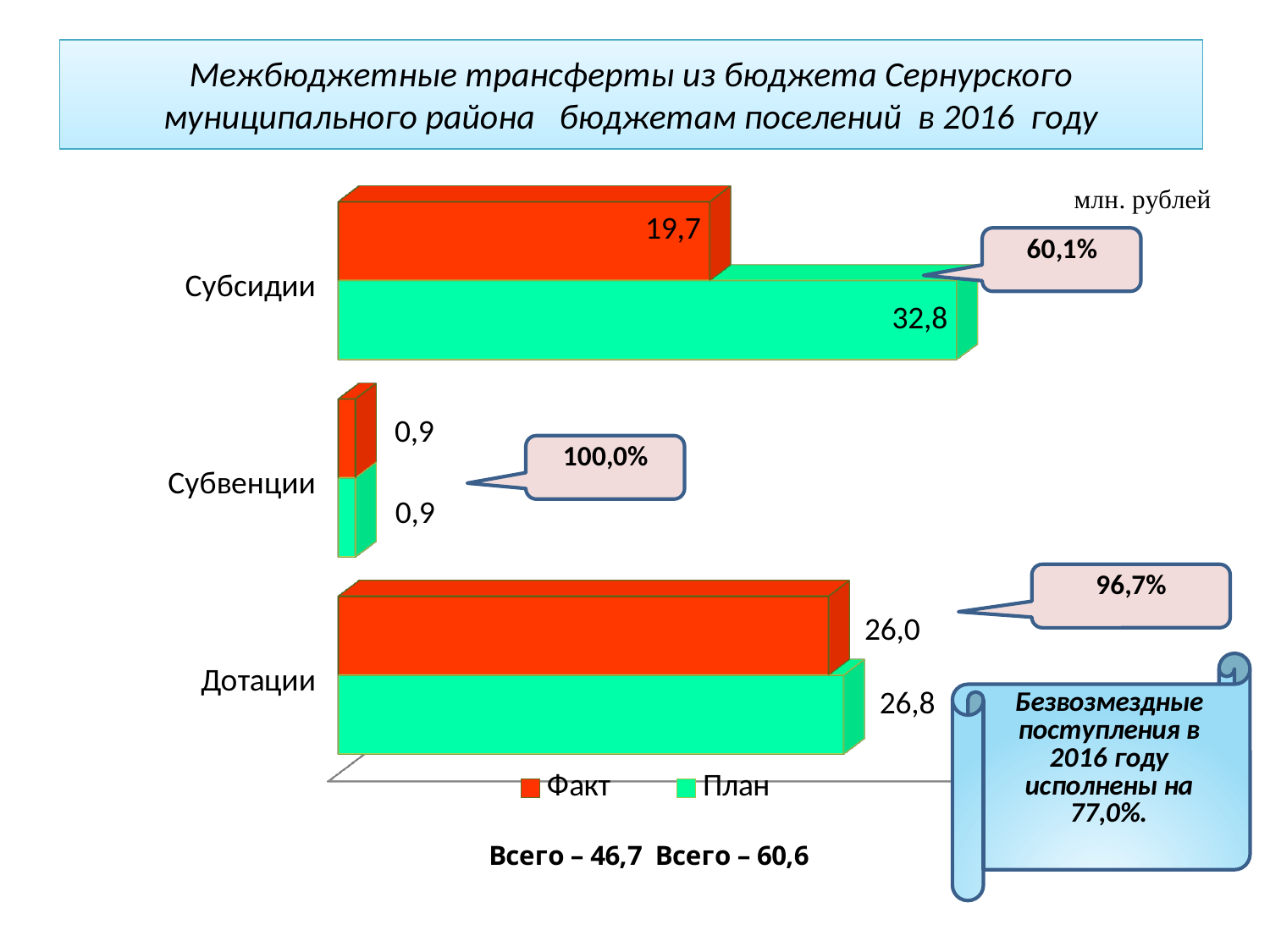
What is the difference between the План and Факт values for Субсидии? 13,1 What kind of chart is shown on the slide? Bar chart How many categories are shown on the chart? 3 What is the Факт value for Субсидии? 19,7 Which is larger for Дотации, the Факт value or the План value? План What percentage is shown in the callout next to the Субсидии bars? 60,1% Which category has the highest План value? Субсидии How many series does the legend list? 2 What is the План value for Субсидии? 32,8 What is the План value for Дотации? 26,8 Which category has the lowest Факт value? Субвенции What is the Факт value for Субвенции? 0,9